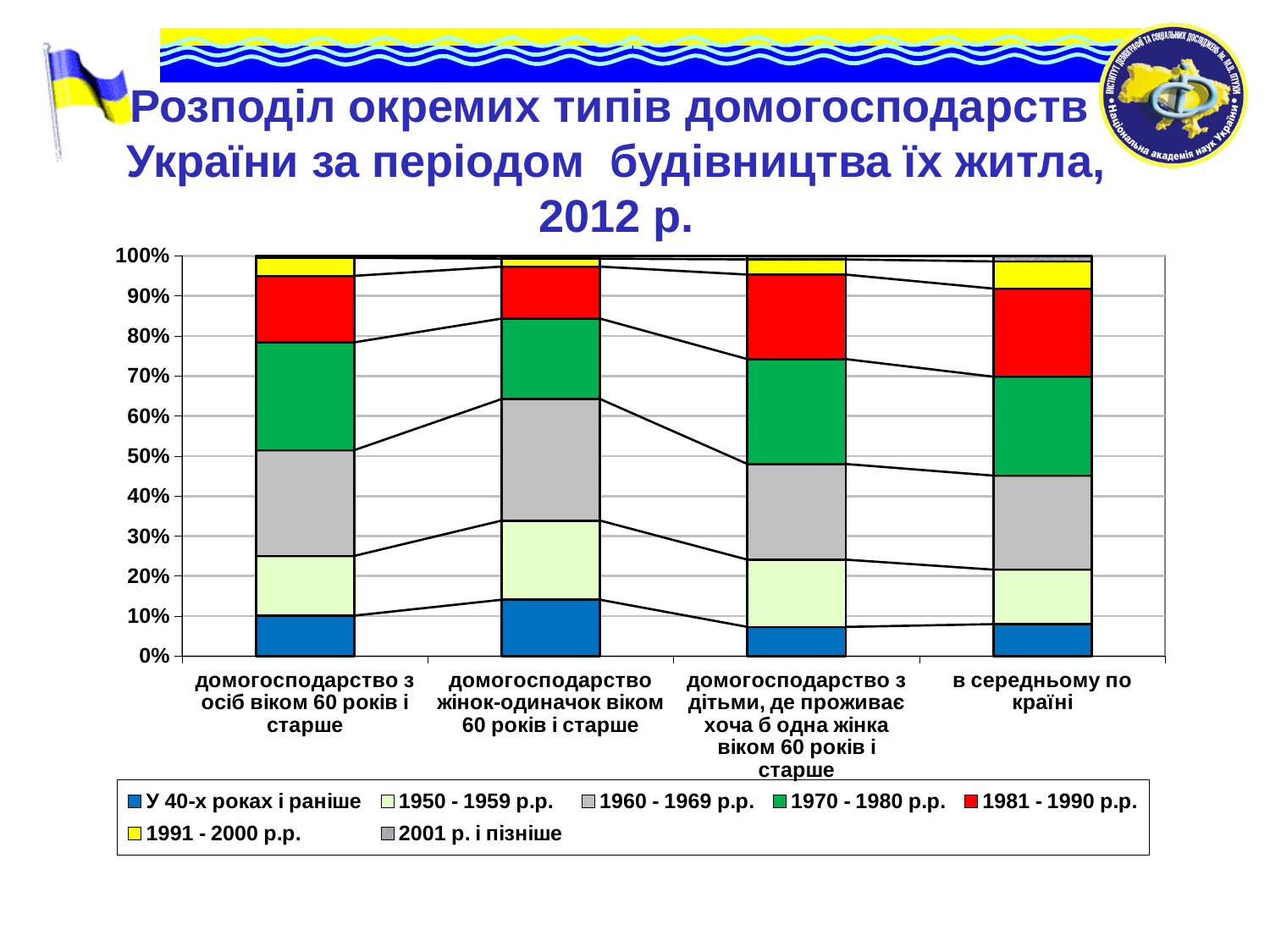
Which category has the largest share for "1991 - 2000 р.р."? в середньому по країні Which category has the largest share for "У 40-х роках і раніше"? домогосподарство жінок-одиначок віком 60 років і старше What colour represents the series "1981 - 1990 р.р." in the chart? red What kind of chart is shown on the slide? stacked bar chart Is the share for "1981 - 1990 р.р." in "в середньому по країні" greater or less than 10%? greater What year does the chart title refer to? 2012 р. How many household categories are shown along the x axis? 4 Which is larger: the share for "1970 - 1980 р.р." in "домогосподарство з осіб віком 60 років і старше" or in "домогосподарство жінок-одиначок віком 60 років і старше"? домогосподарство з осіб віком 60 років і старше Is the share for "У 40-х роках і раніше" in "домогосподарство з дітьми, де проживає хоча б одна жінка віком 60 років і старше" greater or less than 10%? less Is the share for "1960 - 1969 р.р." in "домогосподарство жінок-одиначок віком 60 років і старше" greater or less than 20%? greater How many series (construction periods) does the legend list? 7